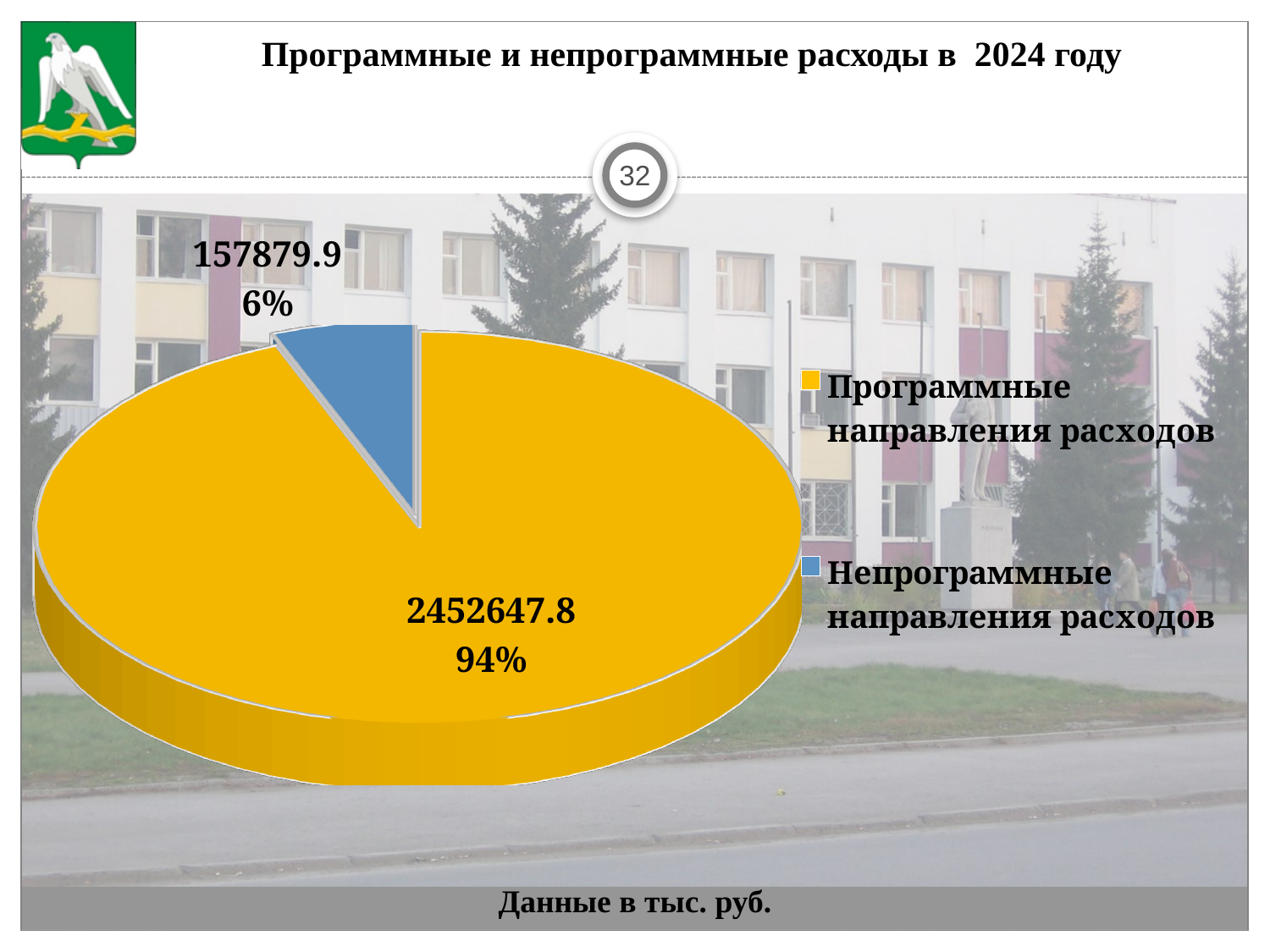
What share of the pie does Программные направления расходов take? 94% How many slices does the pie chart have? 2 What colour is the slice for Непрограммные направления расходов? blue What is the difference between the values for Программные направления расходов and Непрограммные направления расходов? 2294767.9 What is the title of the chart? Программные и непрограммные расходы в 2024 году Which is larger: Программные направления расходов or Непрограммные направления расходов? Программные направления расходов Which category has the largest slice of the pie? Программные направления расходов What is the value for Программные направления расходов? 2452647.8 What share of the pie does Непрограммные направления расходов take? 6% What is the value for Непрограммные направления расходов? 157879.9 What type of chart is shown on the slide? pie chart Which category has the smallest slice of the pie? Непрограммные направления расходов